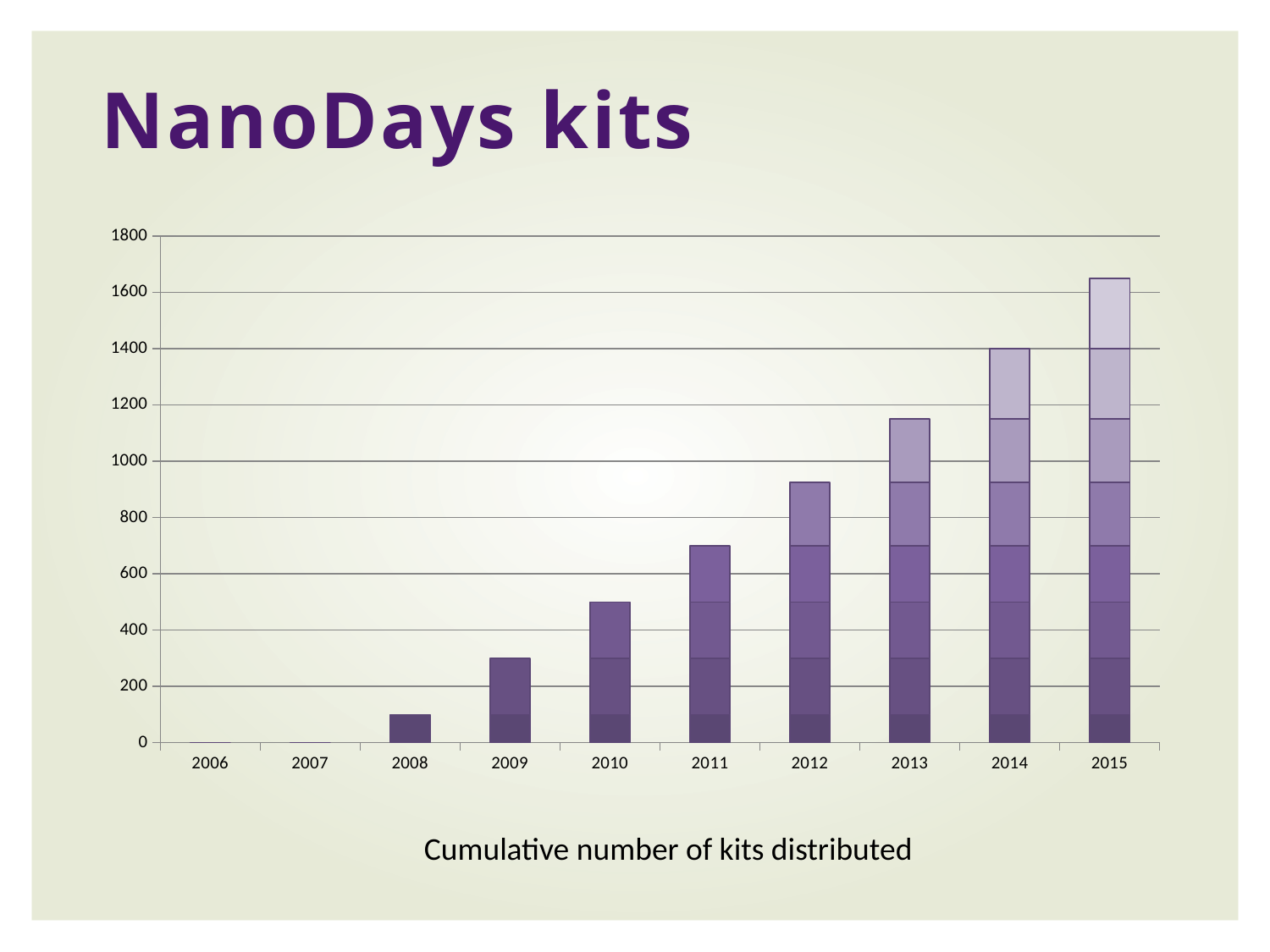
What kind of chart is shown on the slide? bar chart How many years are shown along the x axis of the chart? 10 Is the value for 2013 greater or less than 1000? greater Is the value for 2015 greater or less than 1600? greater Is the value for 2008 greater or less than 200? less Do the bar heights rise or fall from 2008 to 2015? rise What is the cumulative number of kits distributed in 2014? 1400 Which year has the highest cumulative number of kits distributed? 2015 What does the caption below the chart say the chart shows? Cumulative number of kits distributed Which year has a larger value, 2012 or 2013? 2013